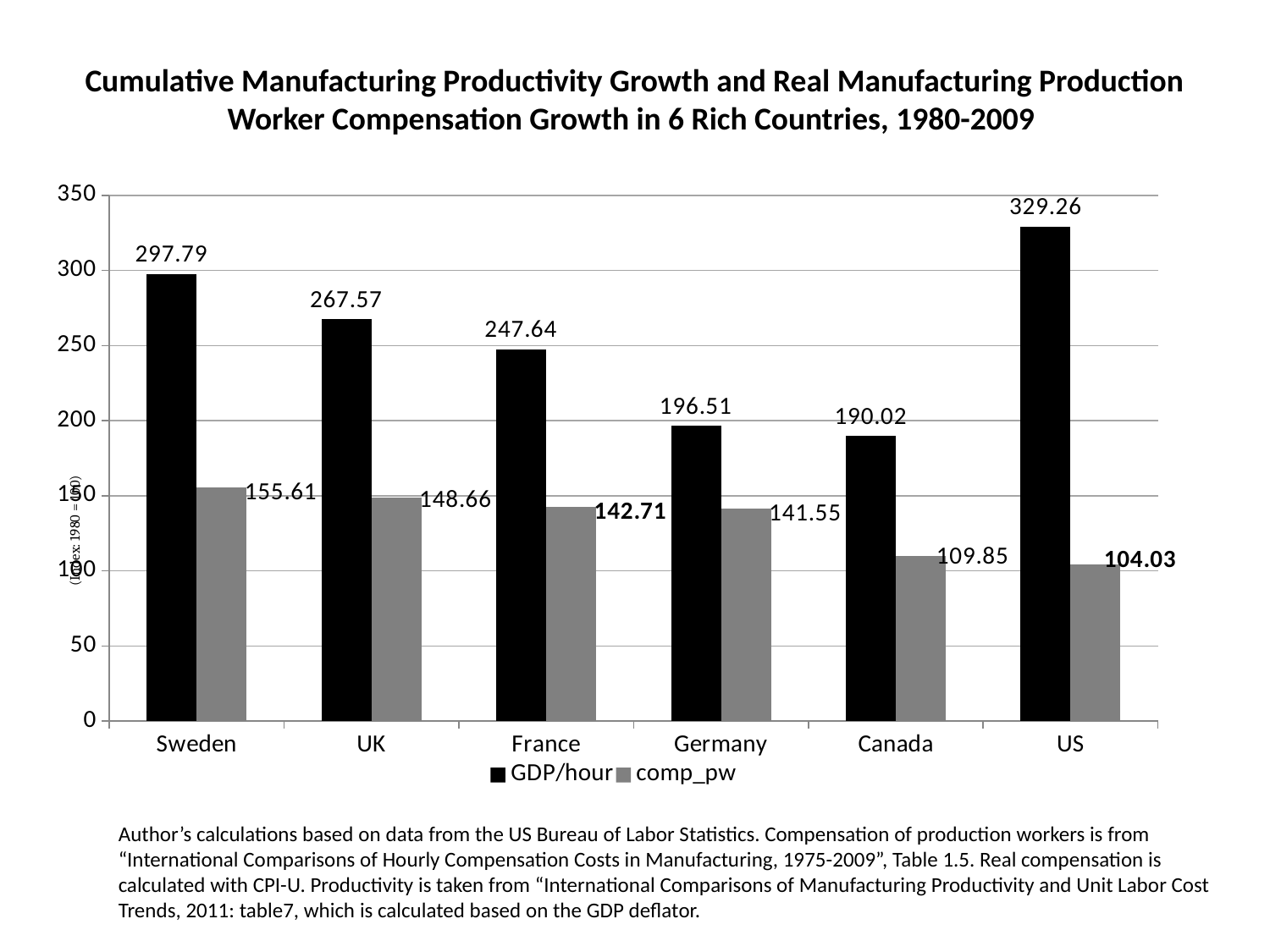
Which country has the highest GDP/hour value? US What is the GDP/hour value for Germany? 196.51 Which country has the lowest comp_pw value? US How many countries are shown on the x axis? 6 What is the comp_pw value for the US? 104.03 What is the GDP/hour value for Sweden? 297.79 What is the difference between the GDP/hour and comp_pw values for the US? 225.23 Which is larger, the GDP/hour value for the UK or the GDP/hour value for France? UK How many series does the legend list? 2 What is the comp_pw value for Canada? 109.85 What kind of chart is shown on the slide? Bar chart Which series is shown in black? GDP/hour